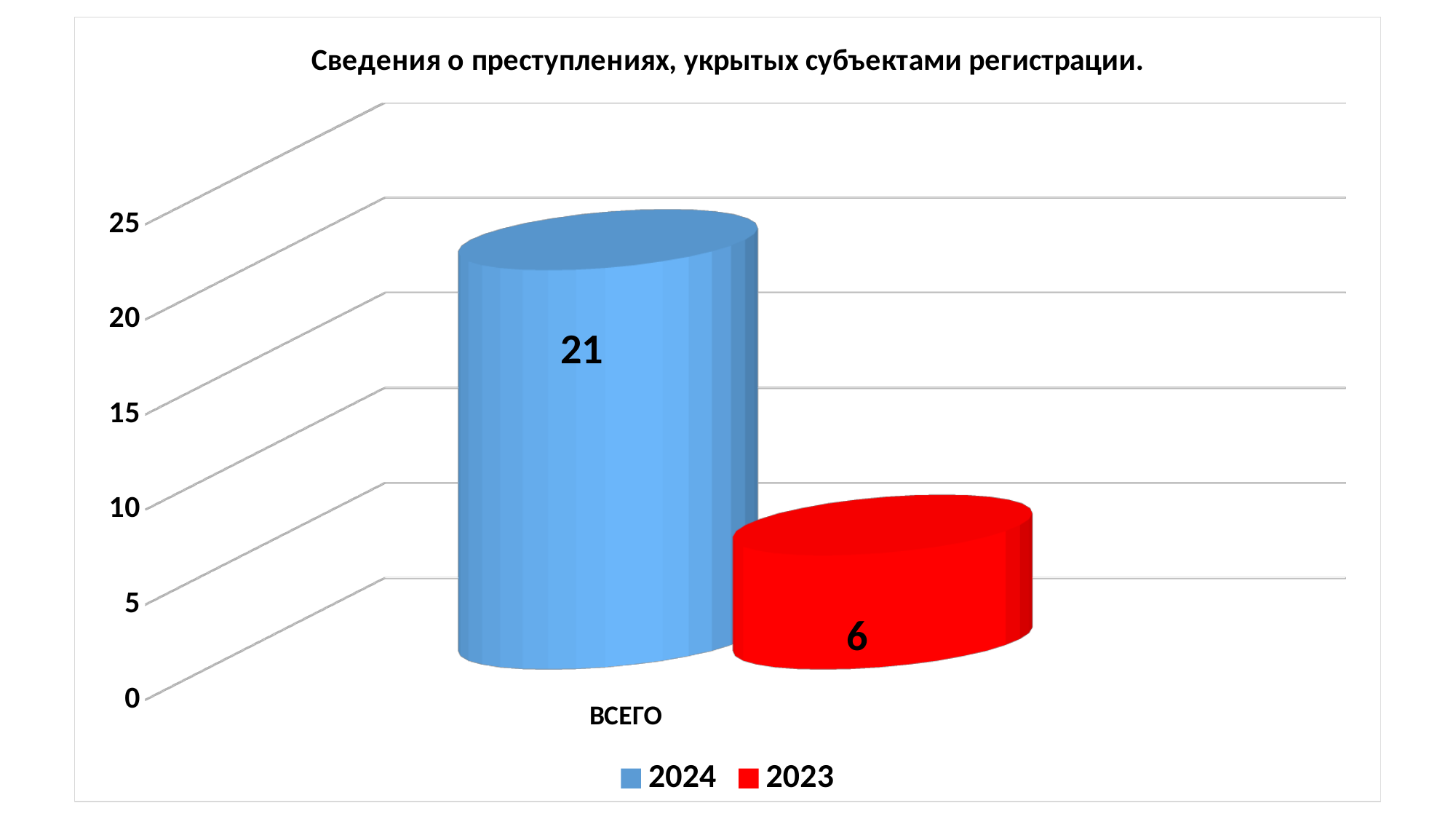
What is the title of the chart? Сведения о преступлениях, укрытых субъектами регистрации. What colour represents the 2023 series? red How many categories are shown on the x axis? 1 What kind of chart is shown on the slide? bar chart What is the value for 2024 in the ВСЕГО category? 21 What is the difference between the 2024 and 2023 values for ВСЕГО? 15 How many series does the legend list? 2 Which series has the higher value for ВСЕГО, 2024 or 2023? 2024 Which series has the lowest value on the chart? 2023 What is the value for 2023 in the ВСЕГО category? 6 Is the value for 2023 greater or less than 10? less Is the value for 2024 greater or less than 20? greater